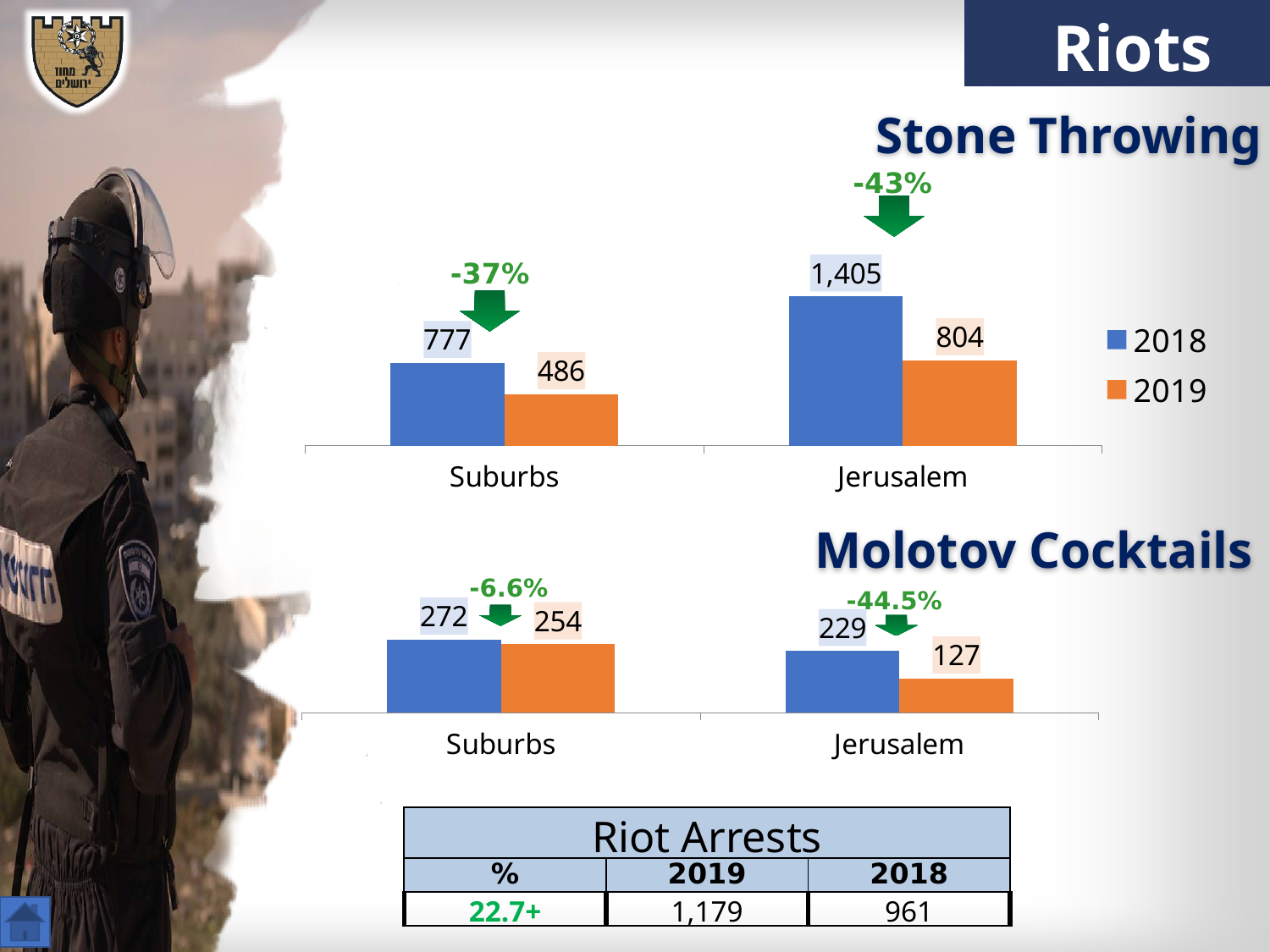
In the Molotov Cocktails chart, which bar has the lowest value? Jerusalem 2019 In the Molotov Cocktails chart, what is the value for Suburbs in 2018? 272 In the Stone Throwing chart, what percentage change is shown above the Jerusalem bars? -43% In the Molotov Cocktails chart, what is the value for Jerusalem in 2019? 127 What type of chart is the Molotov Cocktails chart? Bar chart In the Stone Throwing chart, which is larger: Suburbs 2018 or Jerusalem 2019? Jerusalem 2019 In the Stone Throwing chart, what is the value for Suburbs in 2019? 486 How many series does the legend of the Stone Throwing chart list? 2 In the Stone Throwing chart, what is the value for Jerusalem in 2018? 1,405 In the Stone Throwing chart, which category has the highest 2018 value? Jerusalem In the Stone Throwing chart, what is the difference between the 2018 and 2019 values for Jerusalem? 601 In the Molotov Cocktails chart, what is the difference between the 2018 and 2019 values for Suburbs? 18